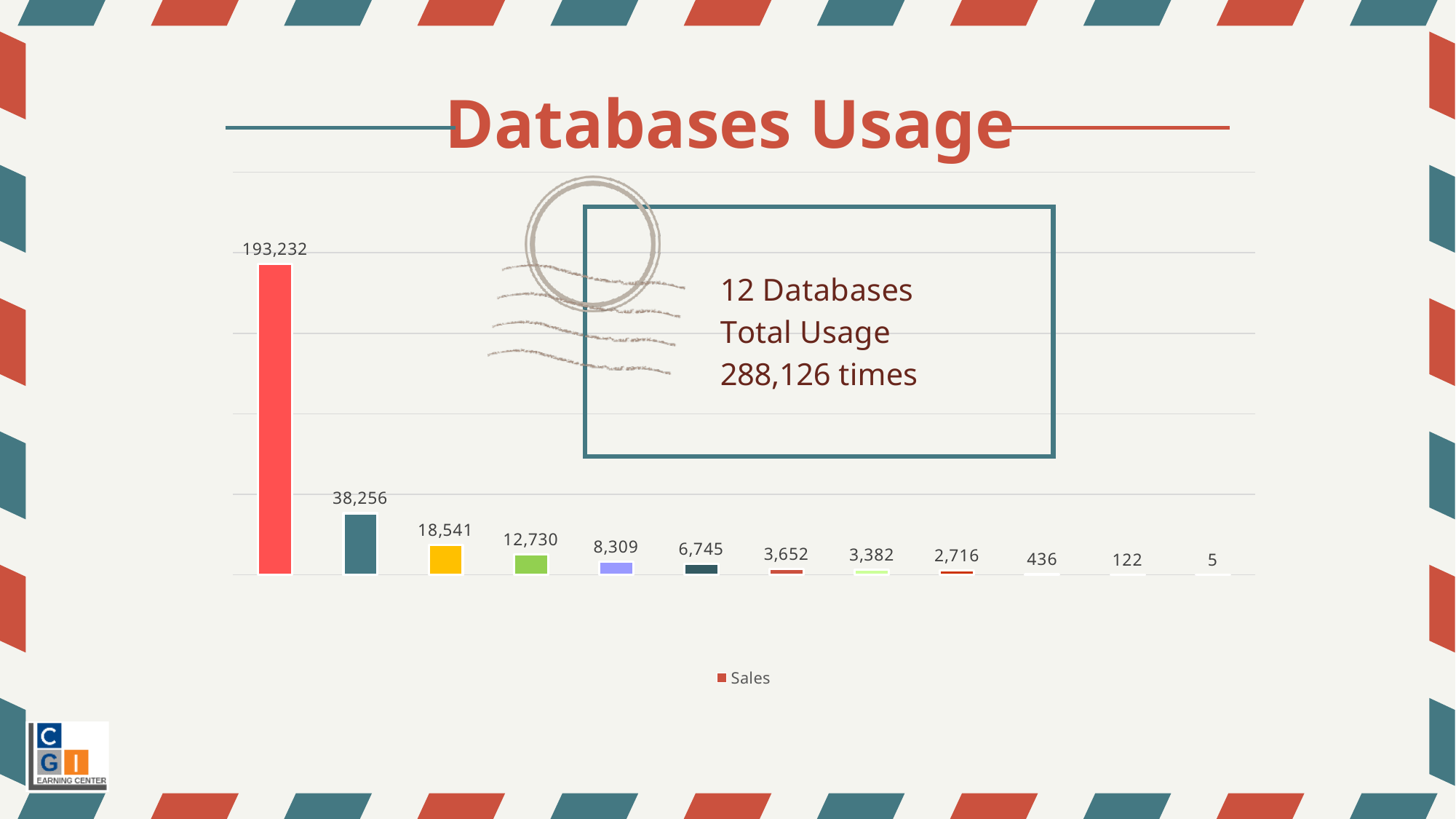
What is the value of the second bar from the left? 38,256 What is the value of the tallest bar in the chart? 193,232 Do the bar values rise or fall from left to right across the chart? fall What is the name of the series shown in the legend? Sales What is the difference between the values of the first and second bars from the left? 154,976 What is the value of the shortest bar in the chart? 5 How many series does the legend list? 1 How many bars are plotted in the chart? 12 What is the value of the third bar from the left? 18,541 What kind of chart is shown on the slide? bar chart Which is larger, the value of the fifth bar from the left or the sixth bar from the left? the fifth bar (8,309) What is the value of the fourth bar from the left? 12,730